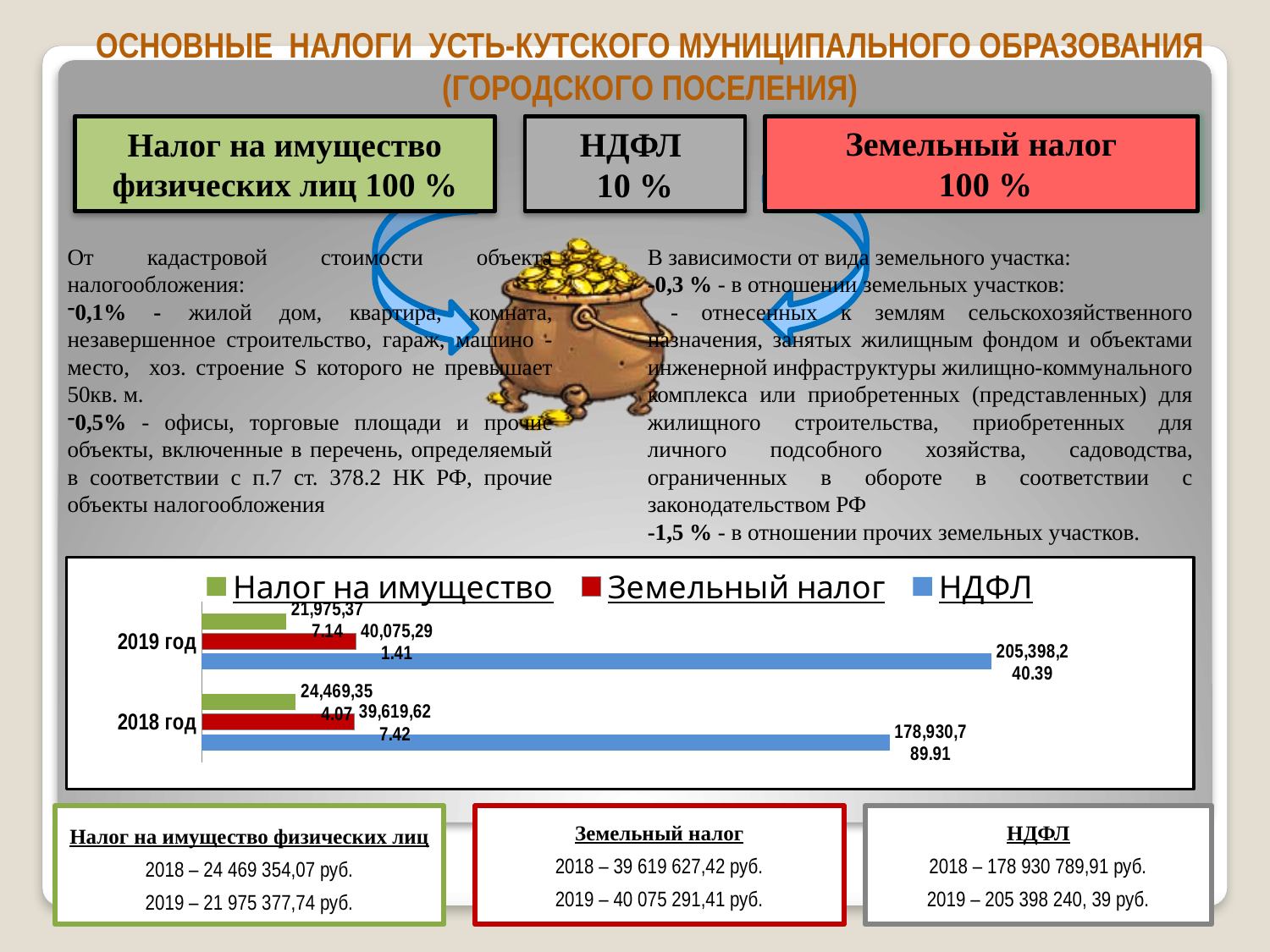
What kind of chart is shown on the slide? bar chart Is the Налог на имущество bar larger for 2018 год or for 2019 год? 2018 год Is the Земельный налог bar larger for 2019 год or for 2018 год? 2019 год Which series has the shortest bar for 2018 год? Налог на имущество How many year categories are shown on the chart's vertical axis? 2 How many series does the chart legend list? 3 Which colour represents the Земельный налог series in the chart? red Is the НДФЛ bar larger for 2019 год or for 2018 год? 2019 год Did the value for Налог на имущество rise or fall from 2018 год to 2019 год? fall Which series is listed first in the chart legend? Налог на имущество Did the value for НДФЛ rise or fall from 2018 год to 2019 год? rise Which series has the longest bar for 2019 год? НДФЛ